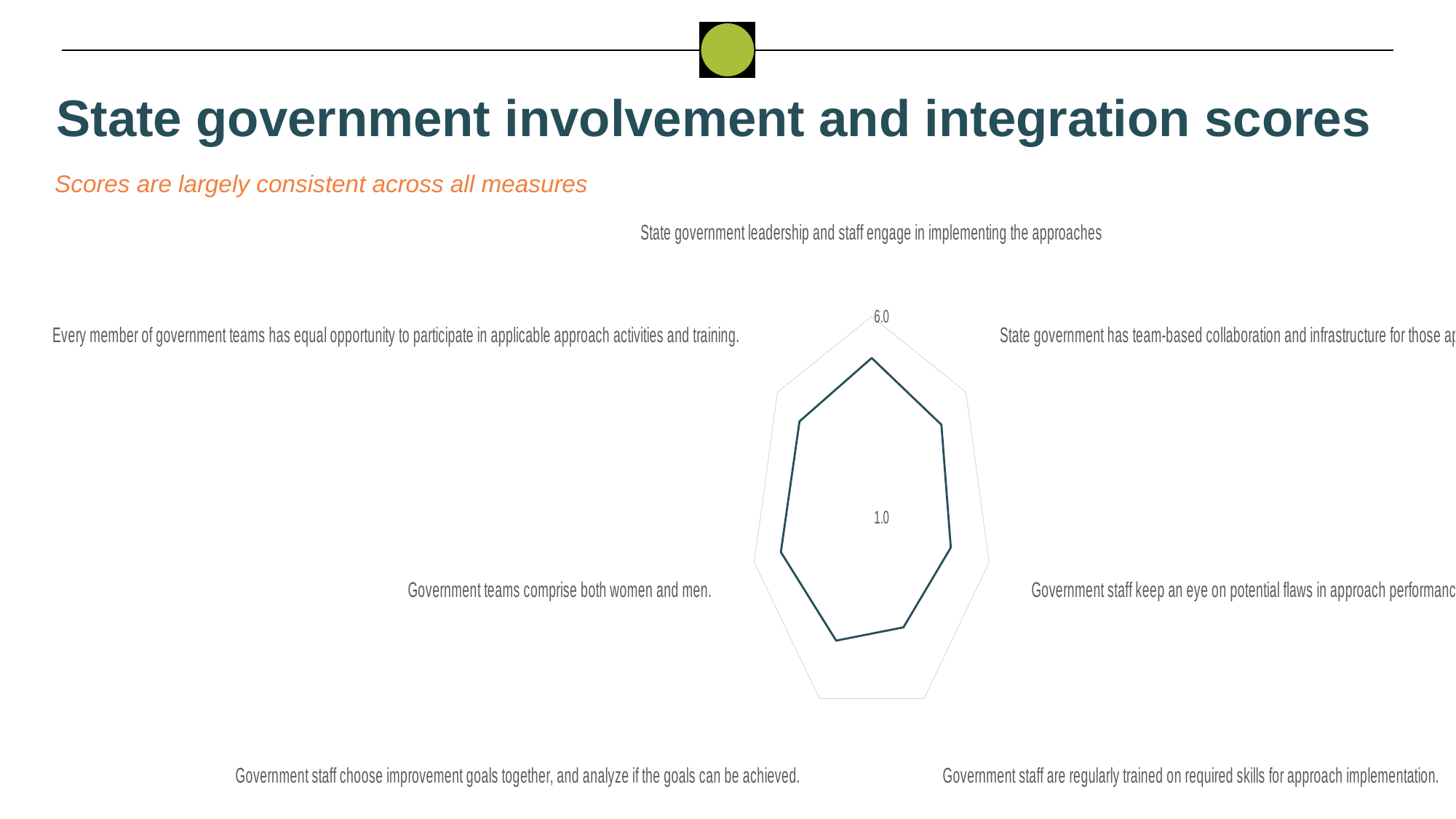
Is the value for 'Government staff are regularly trained on required skills for approach implementation.' greater or less than 6.0? less Is the value for 'Government staff choose improvement goals together, and analyze if the goals can be achieved.' greater or less than 1.0? greater What is the title of the slide containing the radar chart? State government involvement and integration scores What kind of chart is shown on the slide? radar chart Is the value for 'Every member of government teams has equal opportunity to participate in applicable approach activities and training.' greater or less than 6.0? less How many measures (axes) does the radar chart have? 7 What is the highest value shown on the radar chart's axis scale? 6.0